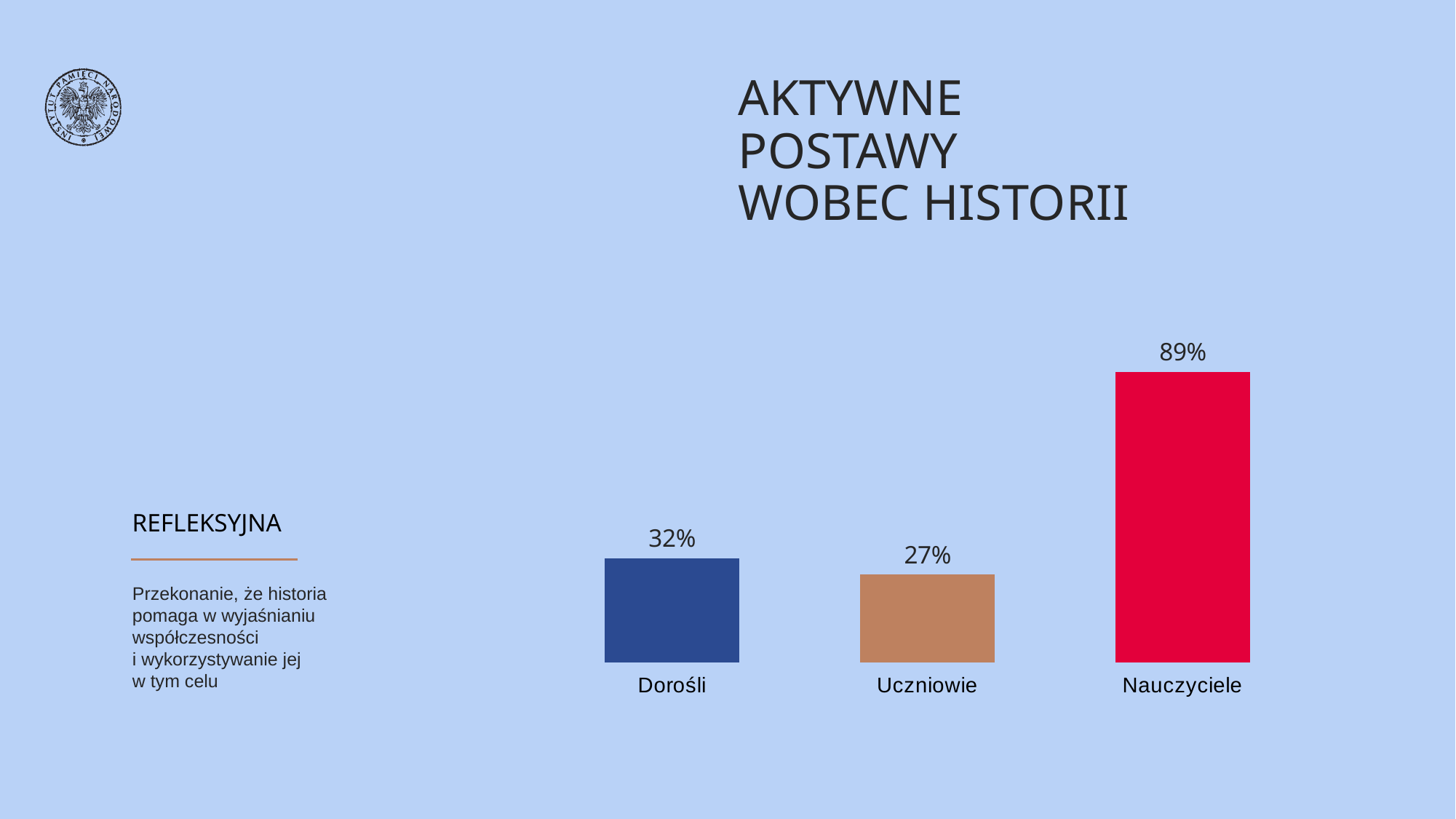
What is the difference between the values for Dorośli and Uczniowie? 5% Which is larger, the value for Dorośli or the value for Uczniowie? Dorośli What is the value for Uczniowie? 27% How many categories are shown in the chart? 3 What is the label of the attitude described next to the chart? REFLEKSYJNA What is the value for Nauczyciele? 89% What is the difference between the values for Nauczyciele and Dorośli? 57% What kind of chart is shown on the slide? Bar chart Which category has the highest value? Nauczyciele Which category has the lowest value? Uczniowie What colour is the bar for Nauczyciele? Red What is the value for Dorośli? 32%